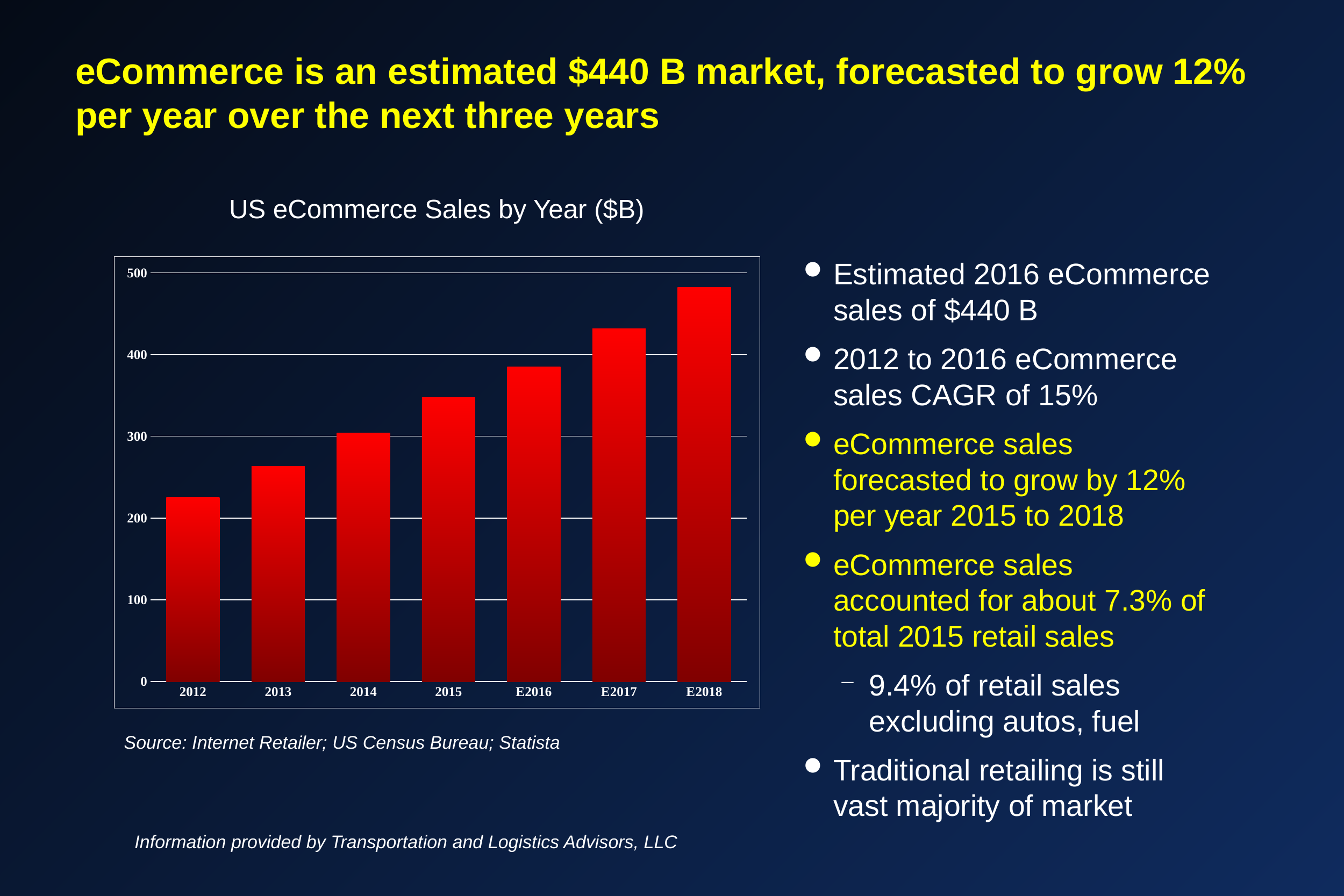
Which year has the highest US eCommerce sales in the chart? E2018 Which is larger, the value for 2014 or the value for E2016? E2016 Is the value for 2015 greater or less than 300? greater What is the title of the chart? US eCommerce Sales by Year ($B) What kind of chart is shown on the slide? bar chart Is the value for 2013 greater or less than 300? less Is the value for E2018 greater or less than 500? less Which year has the lowest US eCommerce sales in the chart? 2012 Do US eCommerce sales rise or fall from 2012 to E2018? rise How many years (bars) are shown in the chart? 7